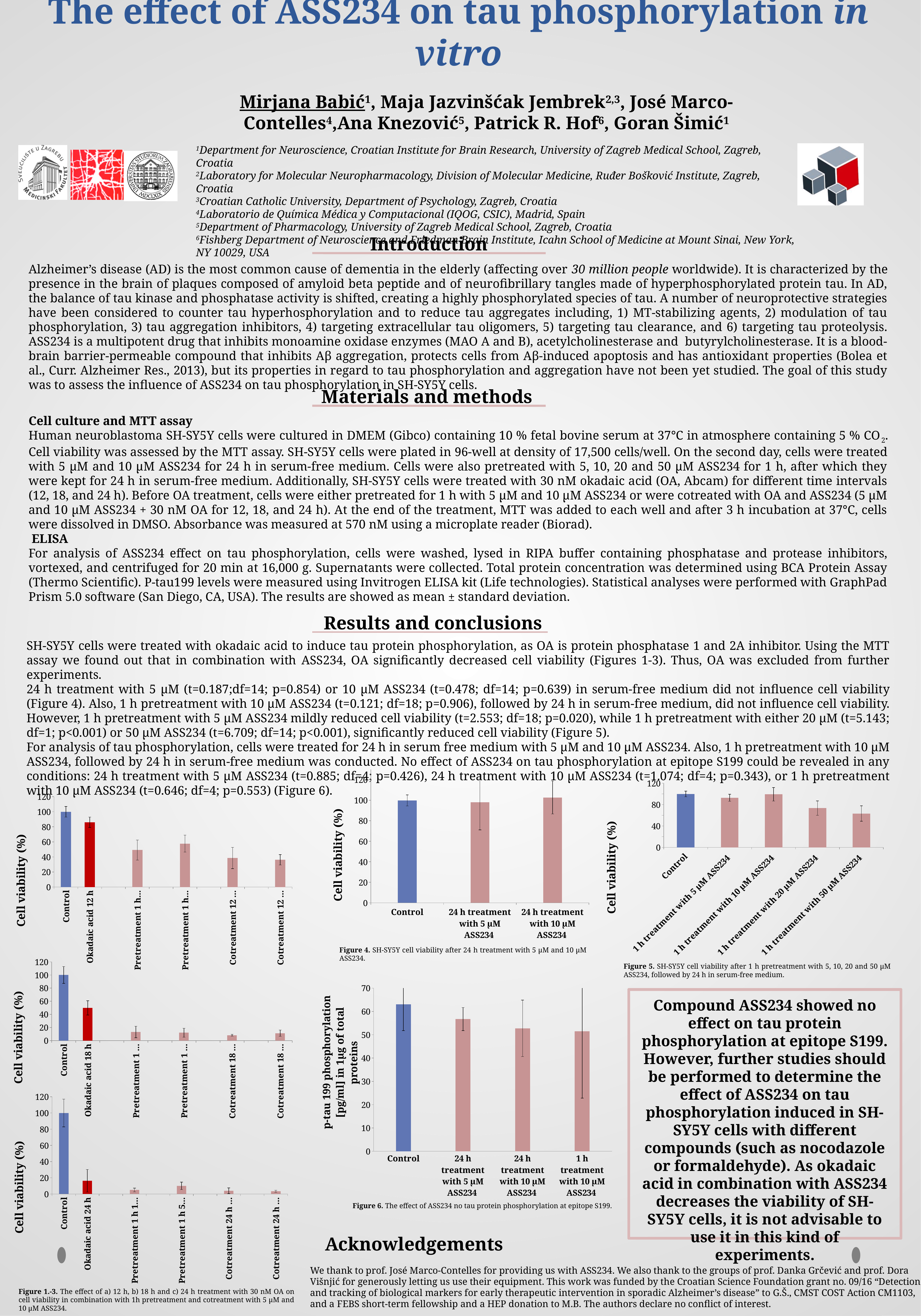
In the top-left chart (Figure 1, okadaic acid 12 h), is the value for Okadaic acid 12 h greater or less than 60? greater What kind of chart is Figure 6 (the effect of ASS234 on tau protein phosphorylation at epitope S199)? bar chart In Figure 6 (p-tau 199 phosphorylation), is the value for 1 h treatment with 10 µM ASS234 greater or less than 60? less In Figure 5 (cell viability after 1 h pretreatment with ASS234), which is larger: the value for Control or the value for 1 h treatment with 50 µM ASS234? Control In Figure 6 (p-tau 199 phosphorylation), how many categories are plotted? 4 In Figure 5 (cell viability after 1 h pretreatment with ASS234), is the value for 1 h treatment with 50 µM ASS234 greater or less than 80? less What is the y-axis label of Figure 6 (the chart on tau protein phosphorylation)? p-tau 199 phosphorylation [pg/ml] in 1µg of total proteins In Figure 4 (SH-SY5Y cell viability after 24 h treatment with 5 µM and 10 µM ASS234), how many categories are plotted? 3 In Figure 6 (p-tau 199 phosphorylation), which category has the highest value? Control In Figure 5 (cell viability after 1 h pretreatment with ASS234), how many categories are plotted? 5